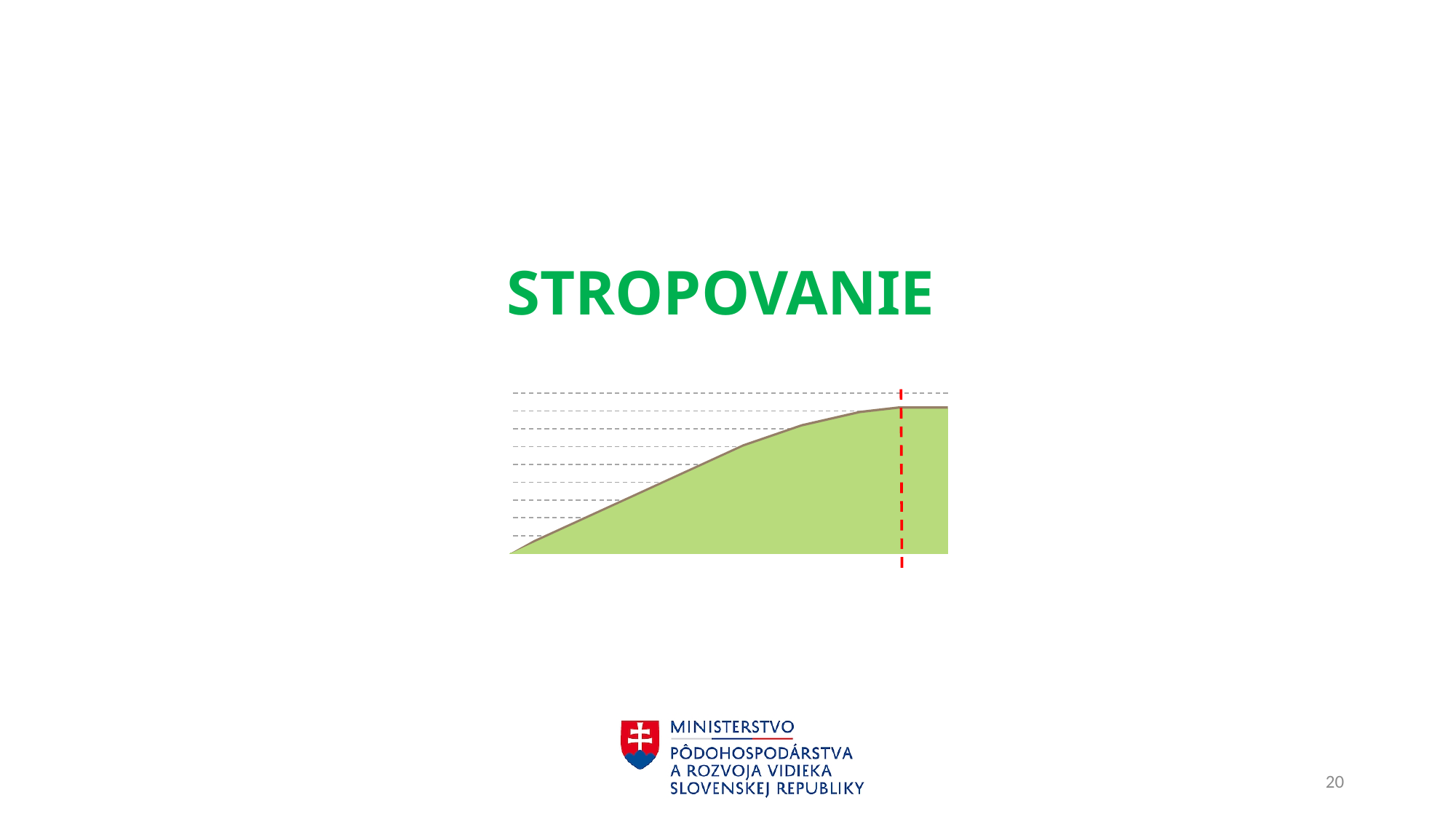
What colour is the filled area under the curve? Green What is the title shown above the chart? STROPOVANIE What kind of chart is shown on the slide? Area chart Do the plotted values rise or fall from left to right along the x axis? Rise Does the curve keep rising or does it flatten out after the red dashed vertical line? Flattens out